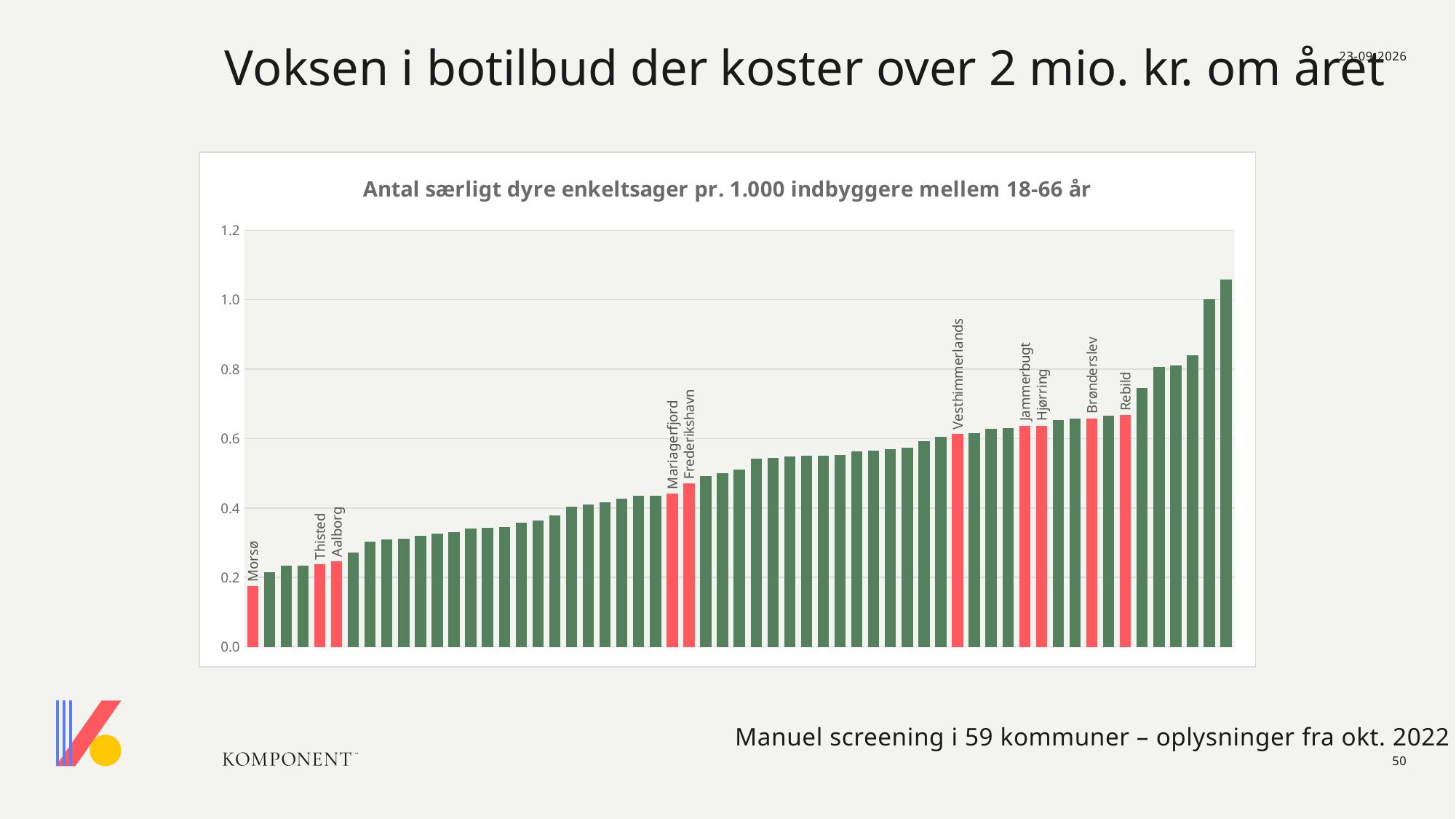
Is the value for Morsø greater or less than 0.2? less Which labelled municipality has the highest bar in the chart? Rebild Is the value for Mariagerfjord greater or less than 0.4? greater Is the value for Thisted greater or less than 0.2? greater What kind of chart is shown on the slide? Bar chart Which labelled municipality has the lowest bar in the chart? Morsø What is the title of the chart? Antal særligt dyre enkeltsager pr. 1.000 indbyggere mellem 18-66 år Do the bar values rise or fall from left to right along the x axis? Rise How many bars in the chart are highlighted in red with a municipality label? 10 Which has the larger value, Aalborg or Jammerbugt? Jammerbugt